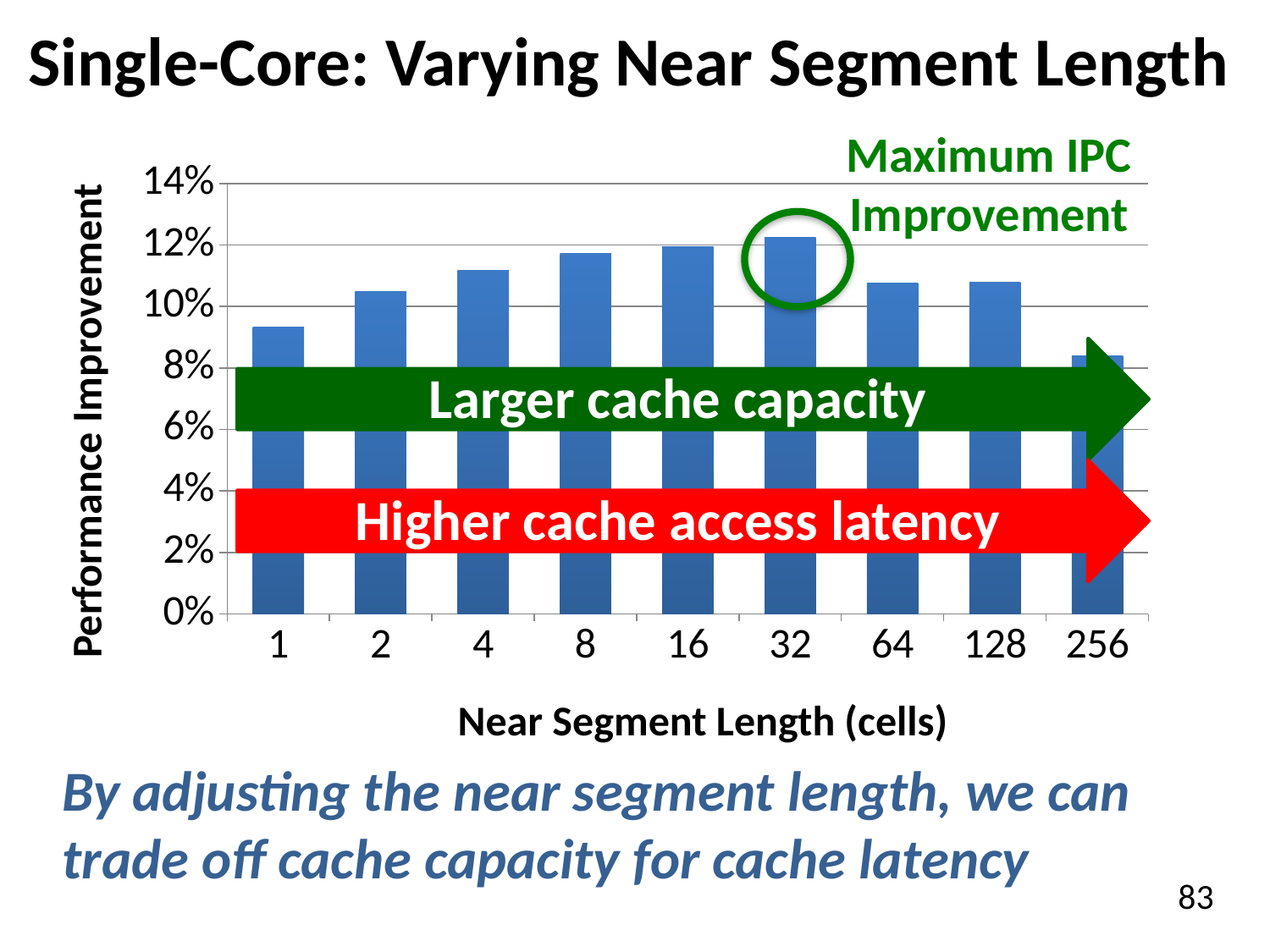
Which has the larger performance improvement: a near segment length of 32 or 1? 32 What kind of chart is shown on the slide? bar chart Is the performance improvement for a near segment length of 1 greater or less than 8%? greater How many near segment length categories are plotted on the x axis? 9 What text is written on the green arrow overlaid on the chart? Larger cache capacity Which near segment length gives the highest performance improvement? 32 Is the performance improvement for a near segment length of 8 greater or less than 10%? greater Which near segment length gives the lowest performance improvement? 256 Is the performance improvement for a near segment length of 64 greater or less than 12%? less What is the label of the x axis? Near Segment Length (cells) Do the performance improvement values rise or fall as the near segment length increases from 1 to 32? rise